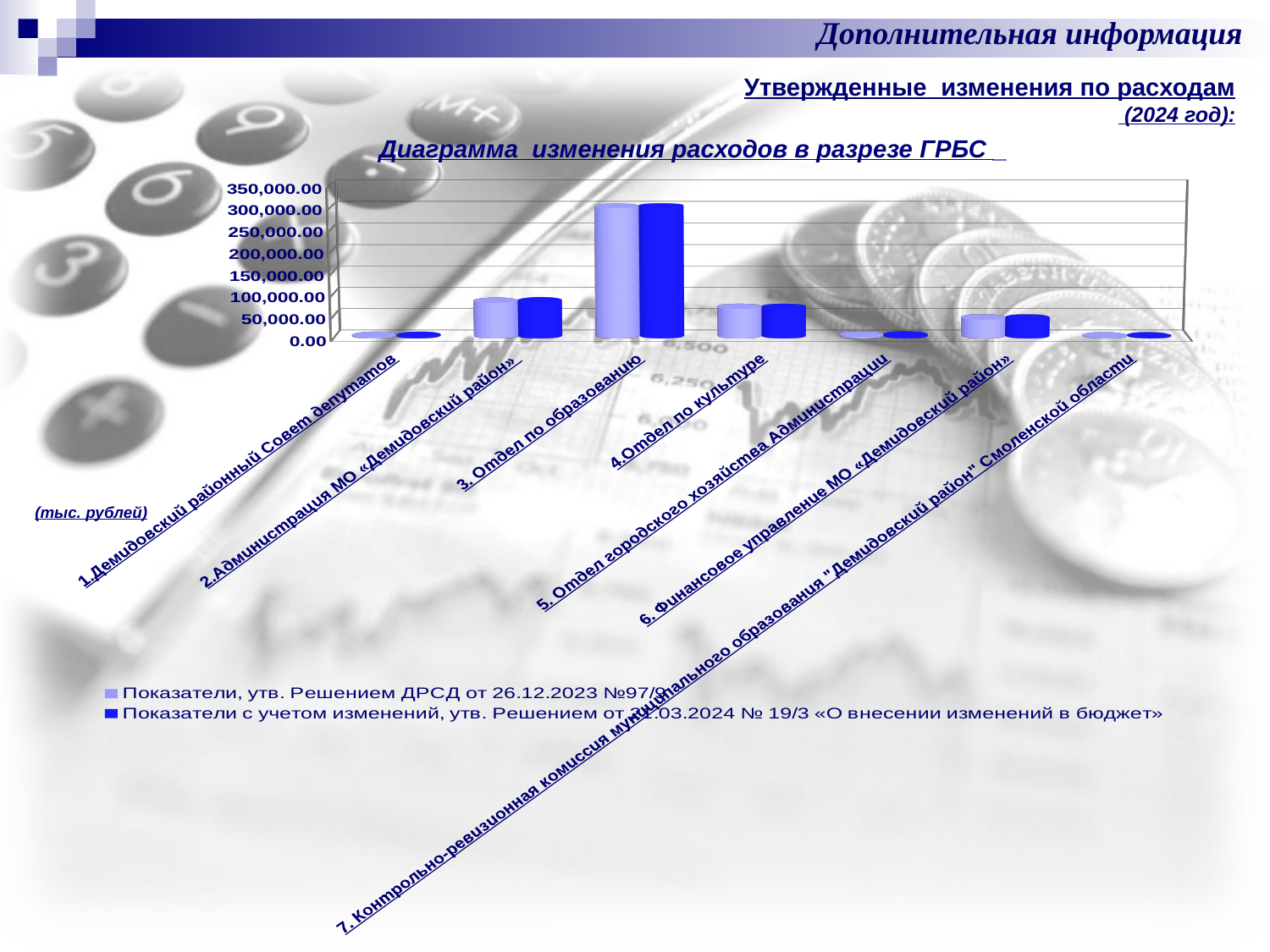
Is the value for «3. Отдел по образованию» in the series «Показатели с учетом изменений» greater or less than 250,000.00? greater How many series does the chart legend list? 2 Which category has the highest values in the chart? 3. Отдел по образованию What kind of chart is shown on the slide? bar chart Which has a larger value in the series «Показатели, утв. Решением ДРСД от 26.12.2023 №97/9»: «2.Администрация МО «Демидовский район»» or «4.Отдел по культуре»? 2.Администрация МО «Демидовский район» What is the title of the chart? Диаграмма изменения расходов в разрезе ГРБС How many categories (ГРБС) are shown on the x axis of the chart? 7 Is the value for «2.Администрация МО «Демидовский район»» in the series «Показатели, утв. Решением ДРСД от 26.12.2023 №97/9» greater or less than 150,000.00? less Is the value for «4.Отдел по культуре» in the series «Показатели с учетом изменений» greater or less than 50,000.00? greater In what units are the chart values given, according to the note on the slide? тыс. рублей Which has a larger value in the series «Показатели с учетом изменений»: «3. Отдел по образованию» or «2.Администрация МО «Демидовский район»»? 3. Отдел по образованию